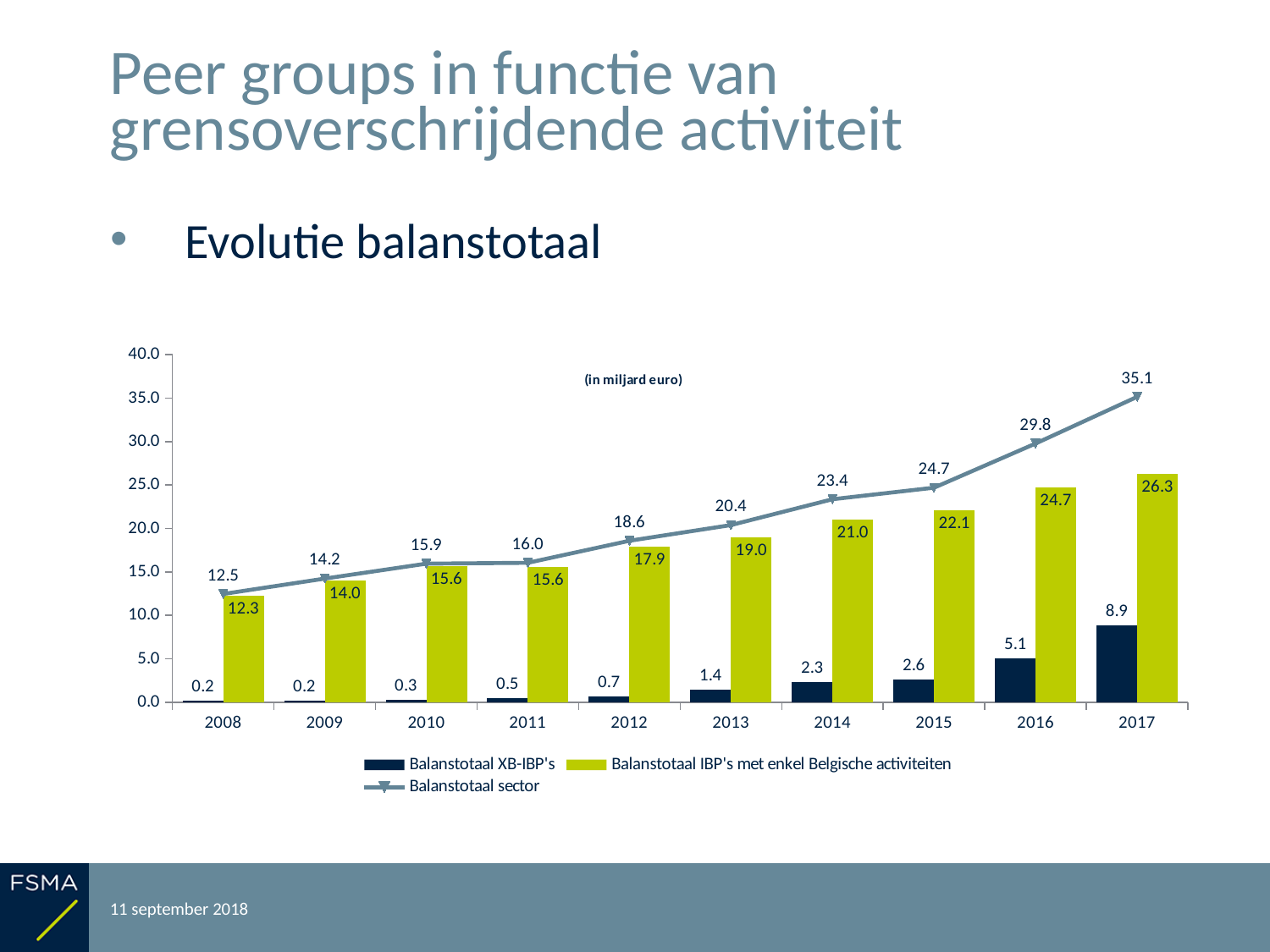
Is the value of Balanstotaal sector in 2016 greater or less than 25.0? greater What kind of chart is shown on the slide? Combined bar and line chart How many series does the legend list? 3 What is the value of Balanstotaal sector in 2017? 35.1 What is the value of Balanstotaal XB-IBP's in 2016? 5.1 Which is larger in 2015: Balanstotaal IBP's met enkel Belgische activiteiten or Balanstotaal XB-IBP's? Balanstotaal IBP's met enkel Belgische activiteiten In which year is Balanstotaal XB-IBP's highest? 2017 Does Balanstotaal sector rise or fall from 2008 to 2017? Rise How many years are shown on the x axis? 10 What is the value of Balanstotaal IBP's met enkel Belgische activiteiten in 2014? 21.0 What is the difference between Balanstotaal sector in 2017 and in 2016? 5.3 In which year is Balanstotaal IBP's met enkel Belgische activiteiten lowest? 2008